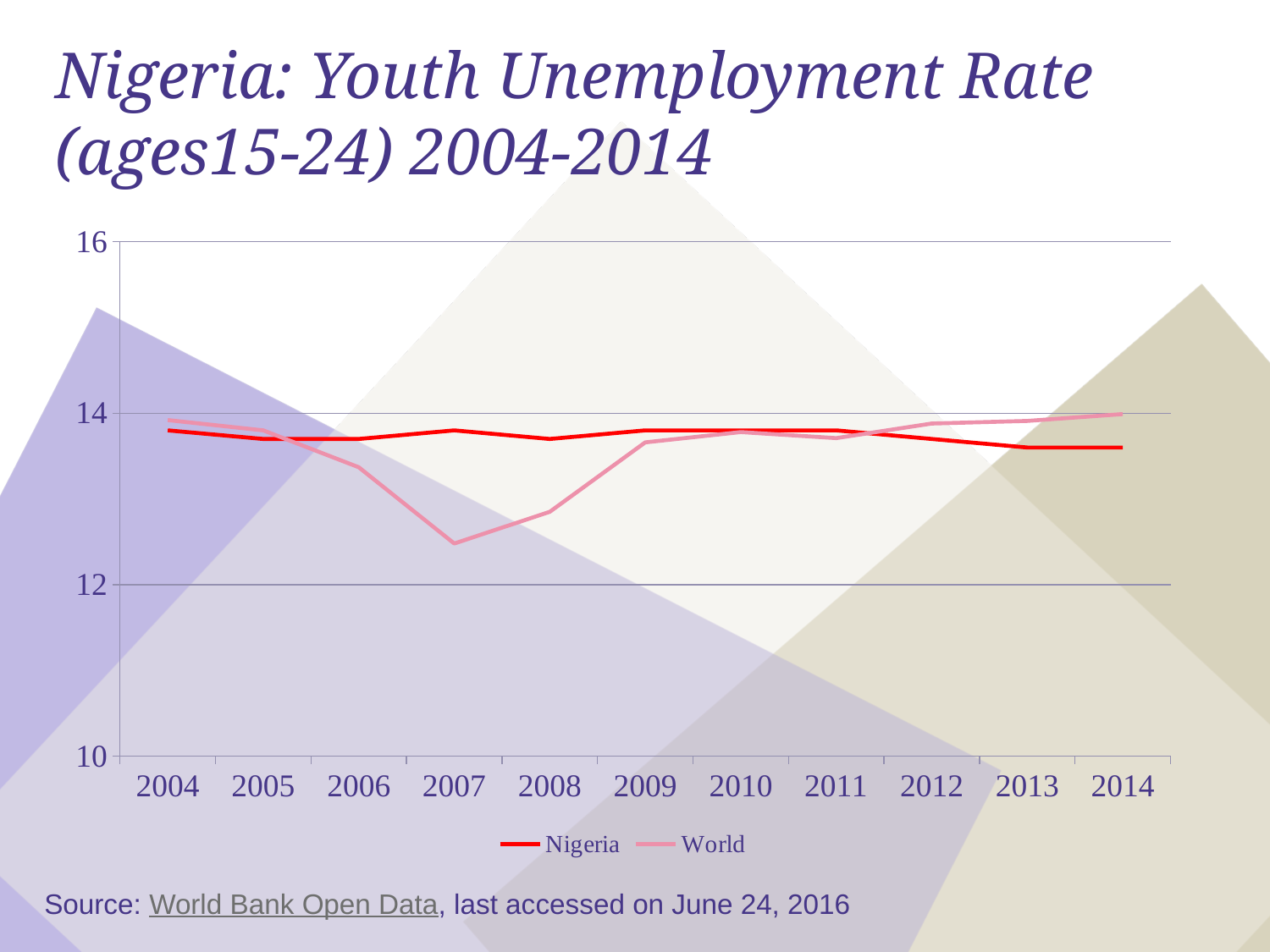
Is the value for Nigeria in 2004 greater or less than 14? less Is the value for World in 2007 greater or less than 14? less Does the World series rise or fall from 2007 to 2009? rise Is the value for World in 2007 greater or less than 12? greater In 2007, which series has the higher value, Nigeria or World? Nigeria Does the Nigeria series rise or fall from 2010 to 2014? fall In 2014, which series has the higher value, Nigeria or World? World In which year is the World series at its lowest? 2007 What kind of chart is shown on the slide? line chart Which two series are listed in the legend? Nigeria and World How many years are plotted along the x axis? 11 How many series does the legend list? 2